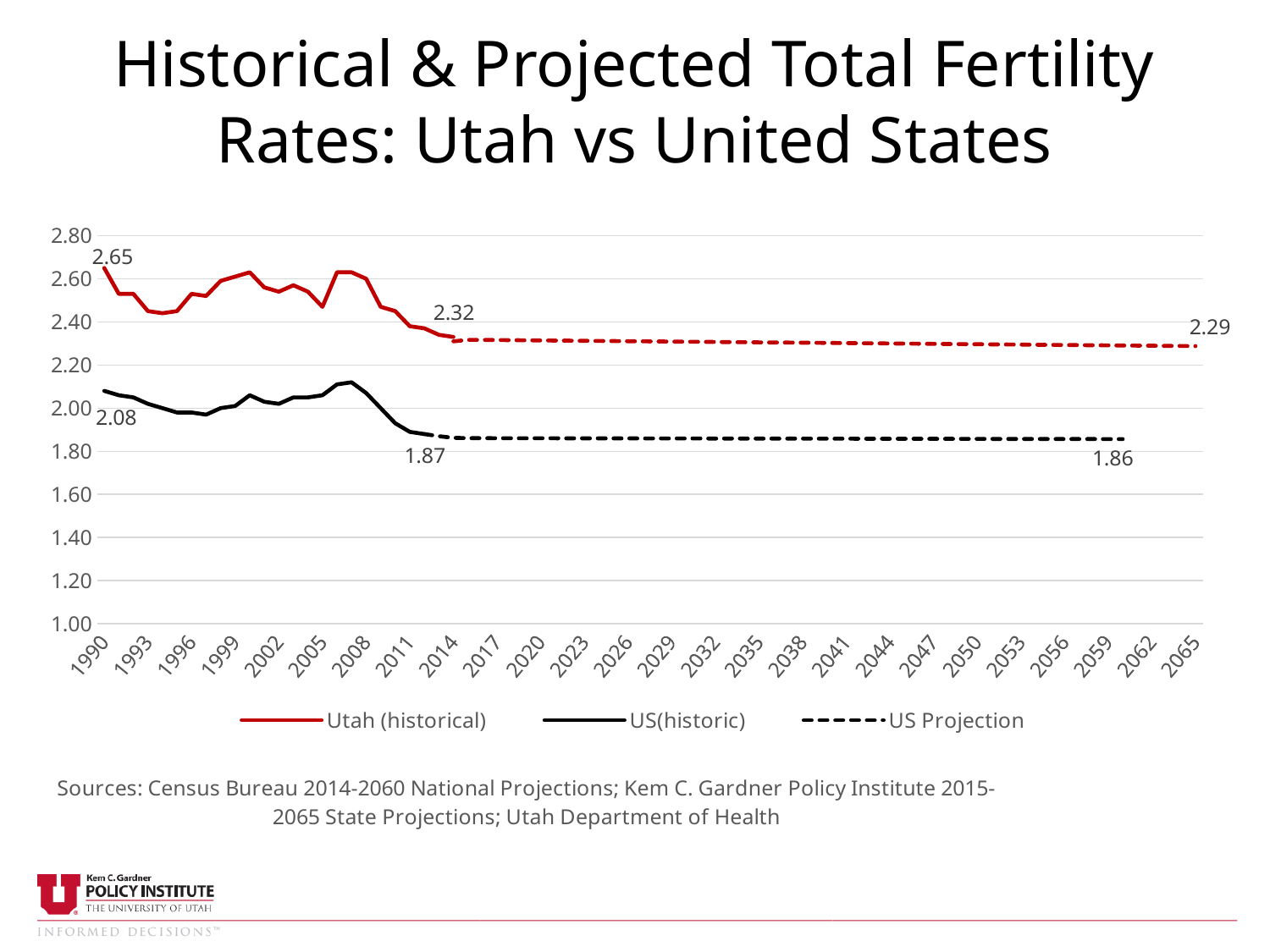
How many series are listed in the legend? 3 What value is labelled at the end of the US Projection line? 1.86 What is the labelled value where the US historic line ends and the projection begins? 1.87 What type of chart is shown on the slide? line chart What is the US total fertility rate labelled at the start of the series in 1990? 2.08 What is the difference between the labelled 1990 values for Utah (2.65) and the US (2.08)? 0.57 Which is higher in 1990, the Utah fertility rate or the US fertility rate? Utah What is the Utah total fertility rate labelled at the start of the series in 1990? 2.65 What value is labelled at the end of the Utah projection line? 2.29 By how much does the labelled Utah value fall from 2.65 in 1990 to 2.32 at the end of the historical series? 0.33 What is the labelled value where the Utah historical line ends and the projection begins? 2.32 Does the Utah historical fertility rate generally rise or fall from 1990 to 2014? fall